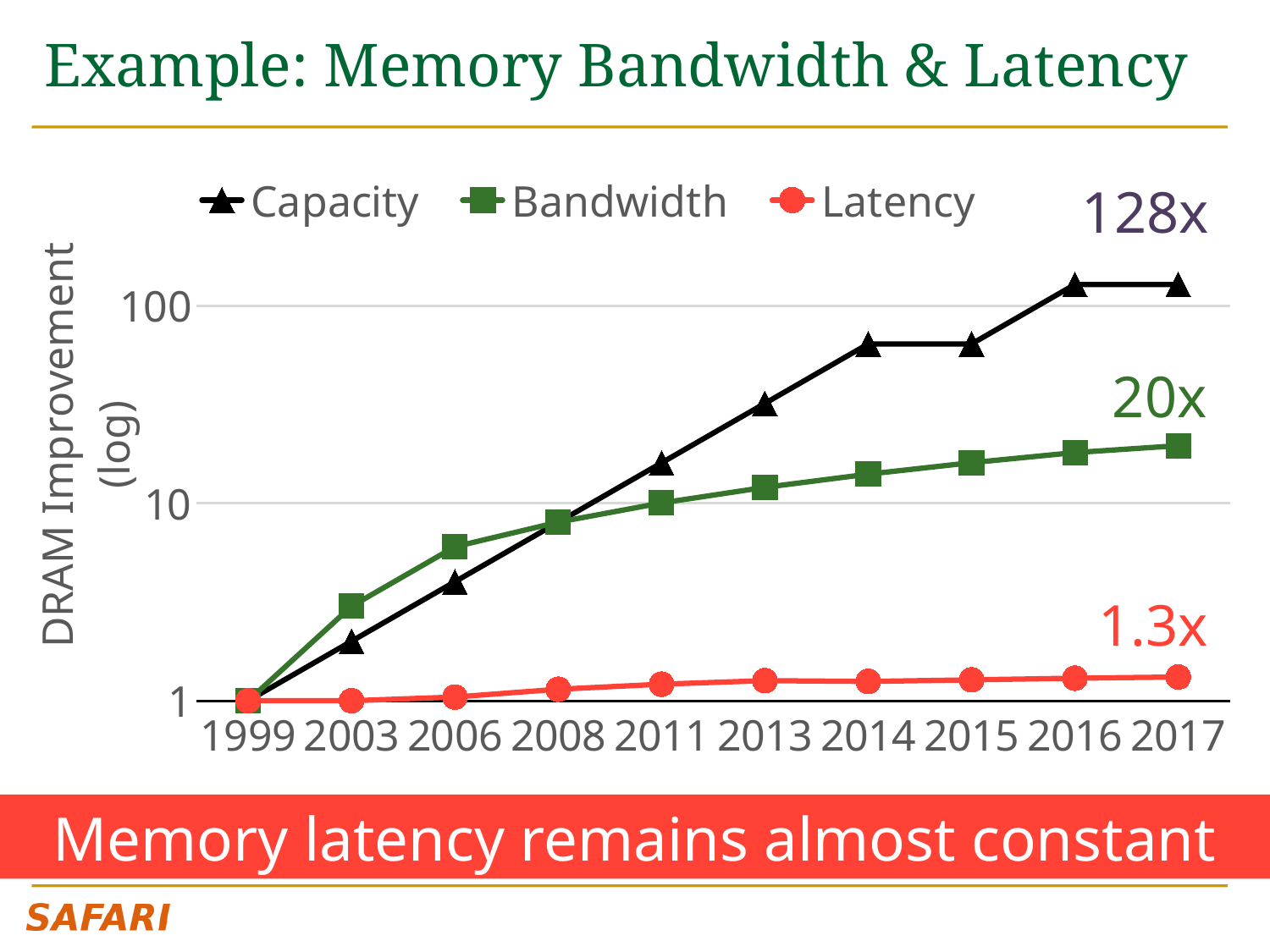
Which series has the lowest value in 2017? Latency How many years are shown on the x axis? 10 What is the Bandwidth improvement in 2017? 20x In 2003, which is larger: Bandwidth or Capacity? Bandwidth What kind of chart is shown on the slide? line chart Is the Capacity value for 2016 greater or less than 100? greater What is the Capacity improvement in 2017? 128x How many series does the legend list? 3 What is the Latency improvement in 2017? 1.3x What is the label of the y axis? DRAM Improvement (log) Which series has the highest value in 2017? Capacity Does the Capacity series rise or fall from 1999 to 2017? rise